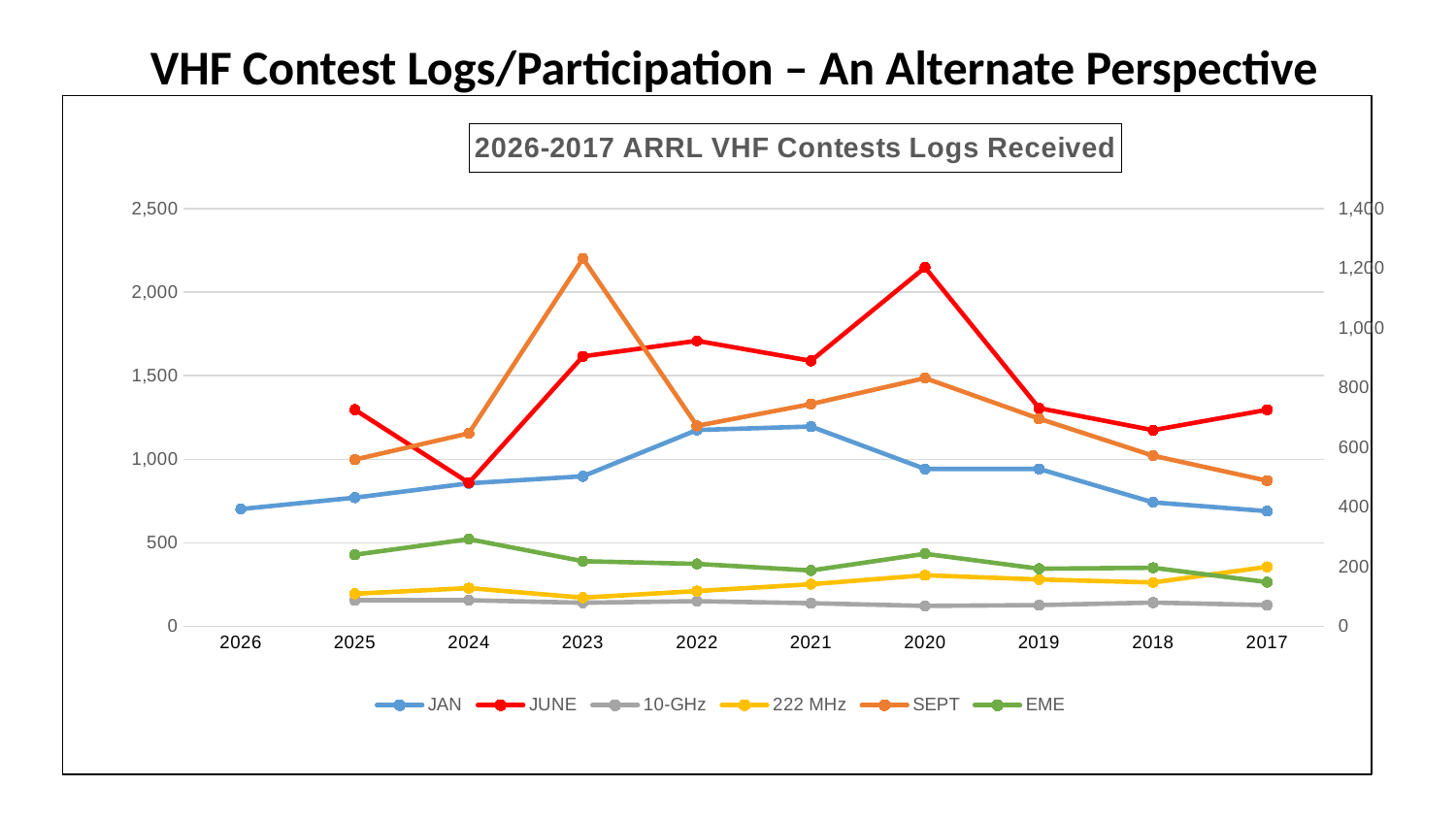
Which series is drawn in red? JUNE How many series does the legend list? 6 What kind of chart is shown on the slide? line chart How many years are shown along the x axis? 10 Does the SEPT series rise or fall from 2020 to 2017? fall In which year does the 222 MHz series reach its highest value? 2017 In which year is the JUNE series at its lowest? 2024 In which year does the SEPT series reach its highest value? 2023 What is the title of the chart? 2026-2017 ARRL VHF Contests Logs Received In which year does the EME series reach its highest value? 2024 Is the JAN value larger in 2022 or in 2020? 2022